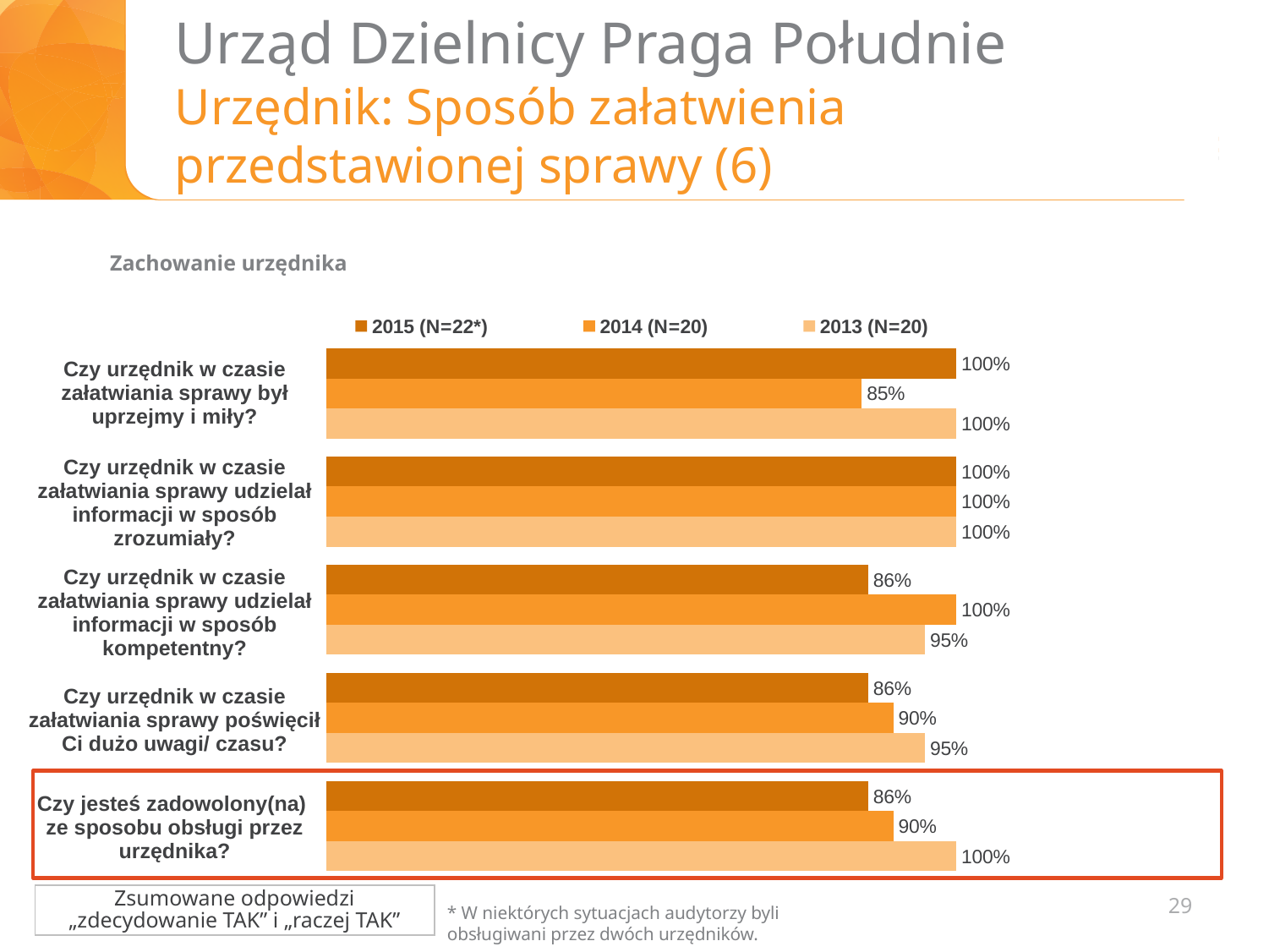
What is the 2013 (N=20) value for "Czy jesteś zadowolony(na) ze sposobu obsługi przez urzędnika?"? 100% Which category is highlighted with a red outline on the chart? Czy jesteś zadowolony(na) ze sposobu obsługi przez urzędnika? For "Czy urzędnik w czasie załatwiania sprawy poświęcił Ci dużo uwagi/ czasu?", which is larger: the 2013 value or the 2015 value? 2013 (N=20) How many question categories are plotted in the chart? 5 Which year has the lowest value for "Czy urzędnik w czasie załatwiania sprawy był uprzejmy i miły?"? 2014 (N=20) How many series does the legend list? 3 What type of chart is shown on the slide? bar chart What is the 2014 (N=20) value for "Czy urzędnik w czasie załatwiania sprawy był uprzejmy i miły?"? 85% What is the 2015 (N=22*) value for "Czy urzędnik w czasie załatwiania sprawy udzielał informacji w sposób kompetentny?"? 86% Which year has the highest value for "Czy urzędnik w czasie załatwiania sprawy udzielał informacji w sposób kompetentny?"? 2014 (N=20) What is the difference between the 2013 and 2015 values for "Czy jesteś zadowolony(na) ze sposobu obsługi przez urzędnika?"? 14% What is the 2014 (N=20) value for "Czy urzędnik w czasie załatwiania sprawy poświęcił Ci dużo uwagi/ czasu?"? 90%